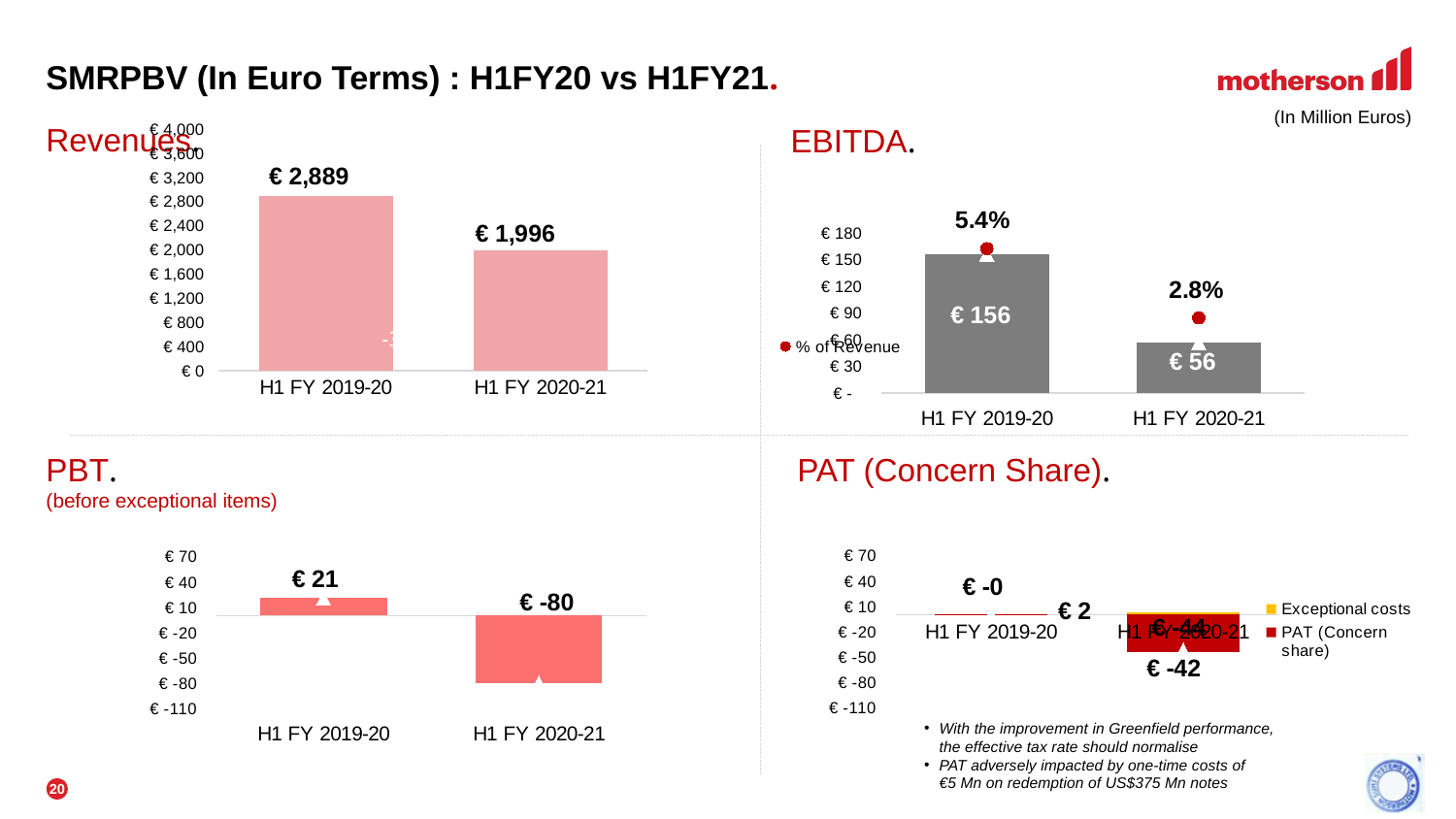
In the Revenues chart, what is the value for H1 FY 2020-21? € 1,996 In the PBT chart, what is the difference between the H1 FY 2019-20 and H1 FY 2020-21 values? € 101 In the EBITDA chart, what is the difference between the EBITDA values for H1 FY 2019-20 and H1 FY 2020-21? € 100 In the Revenues chart, what is the difference between the H1 FY 2019-20 and H1 FY 2020-21 values? € 893 In the EBITDA chart, what is the EBITDA value for H1 FY 2020-21? € 56 In the PBT chart, what is the value for H1 FY 2020-21? € -80 In the EBITDA chart, what is the % of Revenue for H1 FY 2020-21? 2.8% In the EBITDA chart, what is the EBITDA value for H1 FY 2019-20? € 156 In the PBT chart, which period has the higher value? H1 FY 2019-20 What kind of chart is the Revenues chart? Bar chart How many series does the legend of the PAT (Concern Share) chart list? 2 In the Revenues chart, what is the value for H1 FY 2019-20? € 2,889